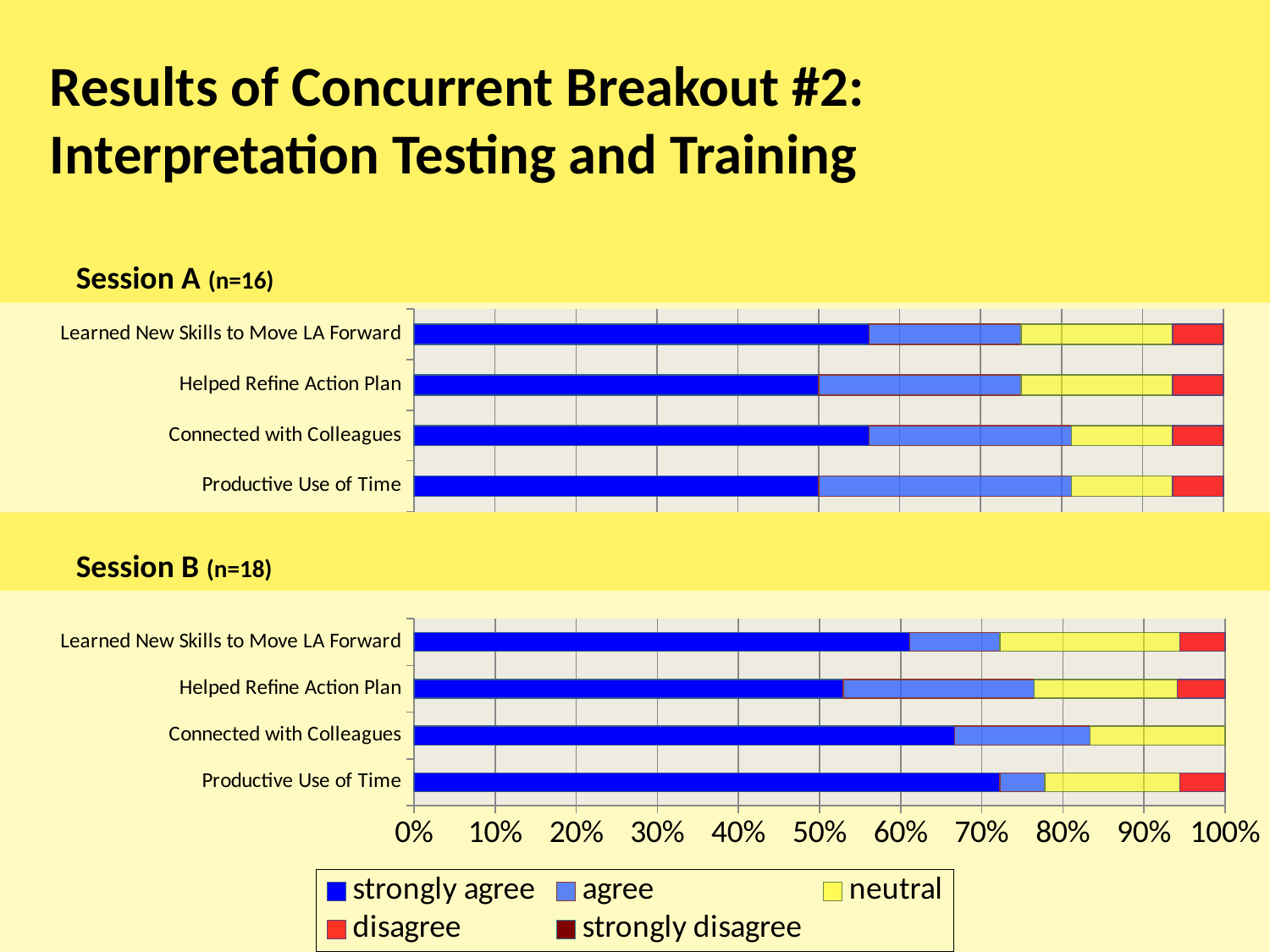
In the Session B (n=18) chart, is the strongly agree value for Helped Refine Action Plan greater or less than 60%? less What kind of chart is used for Session A (n=16)? stacked bar chart How many categories are shown in the Session B (n=18) chart? 4 In the Session A (n=16) chart, is the strongly agree value for Learned New Skills to Move LA Forward greater or less than 50%? greater In the Session B (n=18) chart, which category has no disagree segment? Connected with Colleagues How many series does the legend list? 5 What is the sample size (n) given for Session A? 16 In the Session B (n=18) chart, which has the larger strongly agree share: Productive Use of Time or Learned New Skills to Move LA Forward? Productive Use of Time In the Session B (n=18) chart, is the strongly agree value for Connected with Colleagues greater or less than 60%? greater In the Session B (n=18) chart, which category has the highest strongly agree share? Productive Use of Time In the Session B (n=18) chart, which category has the lowest strongly agree share? Helped Refine Action Plan